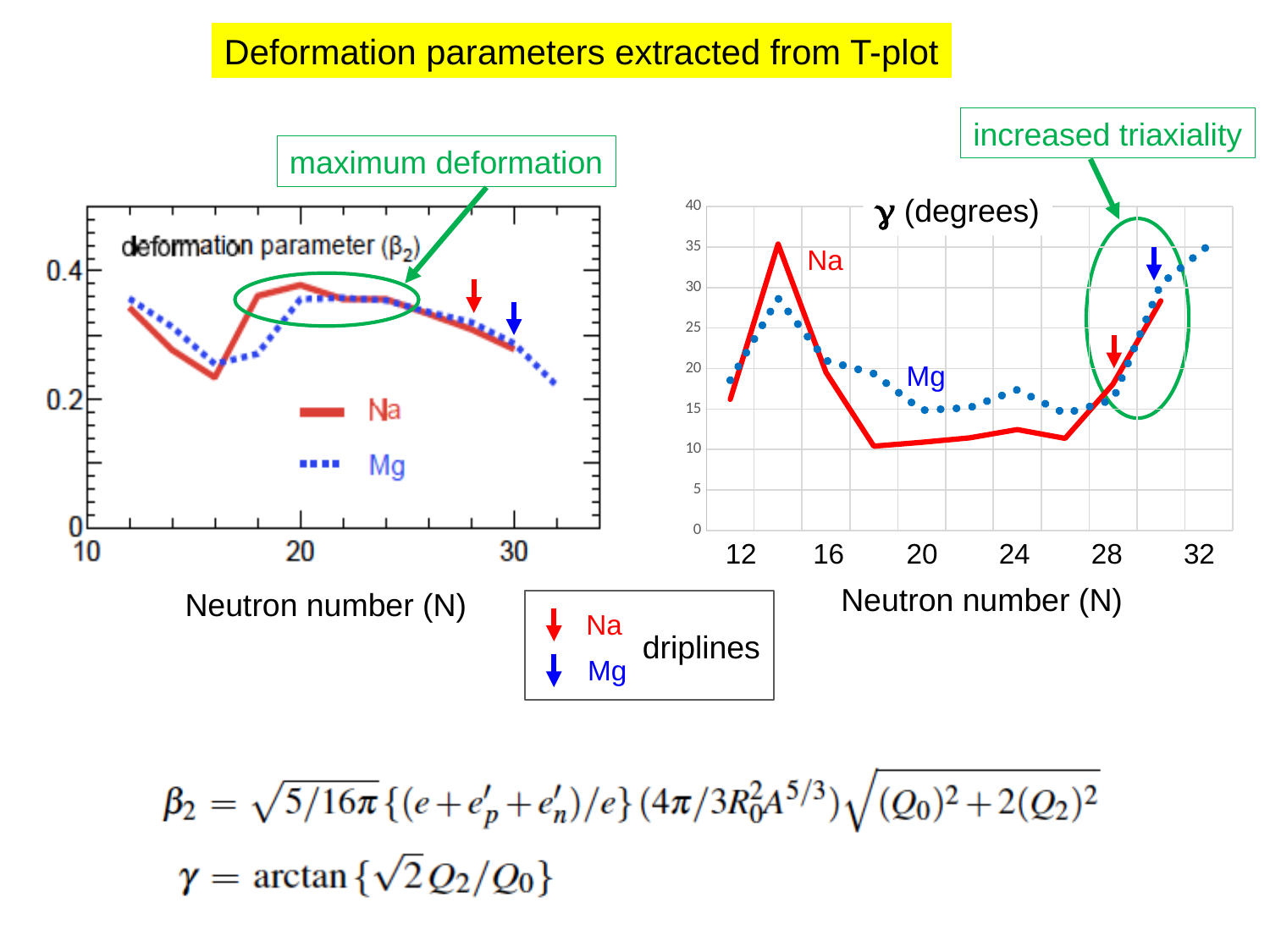
In the right chart (γ in degrees), is the Na value at neutron number 18 greater or less than 15? less In the left chart (deformation parameter), does the Na curve rise or fall between neutron number 20 and neutron number 30? fall In the left chart (deformation parameter), is the Na value at neutron number 20 greater or less than 0.2? greater In the right chart (γ in degrees), which series has the larger value at neutron number 18, Na or Mg? Mg In the left chart (deformation parameter), which series has the larger value at neutron number 18, Na or Mg? Na What is the x-axis label of the right chart (γ in degrees)? Neutron number (N) What kind of chart is the left chart showing the deformation parameter (β2)? line chart In the right chart (γ in degrees), does the Na curve rise or fall between neutron number 26 and neutron number 30? rise In the right chart (γ in degrees), which series has the larger value at neutron number 14, Na or Mg? Na In the right chart (γ in degrees), is the Mg value at neutron number 32 greater or less than 30? greater In the right chart (γ in degrees), which two series are plotted? Na and Mg How many series does the legend of the left chart (deformation parameter) list? 2